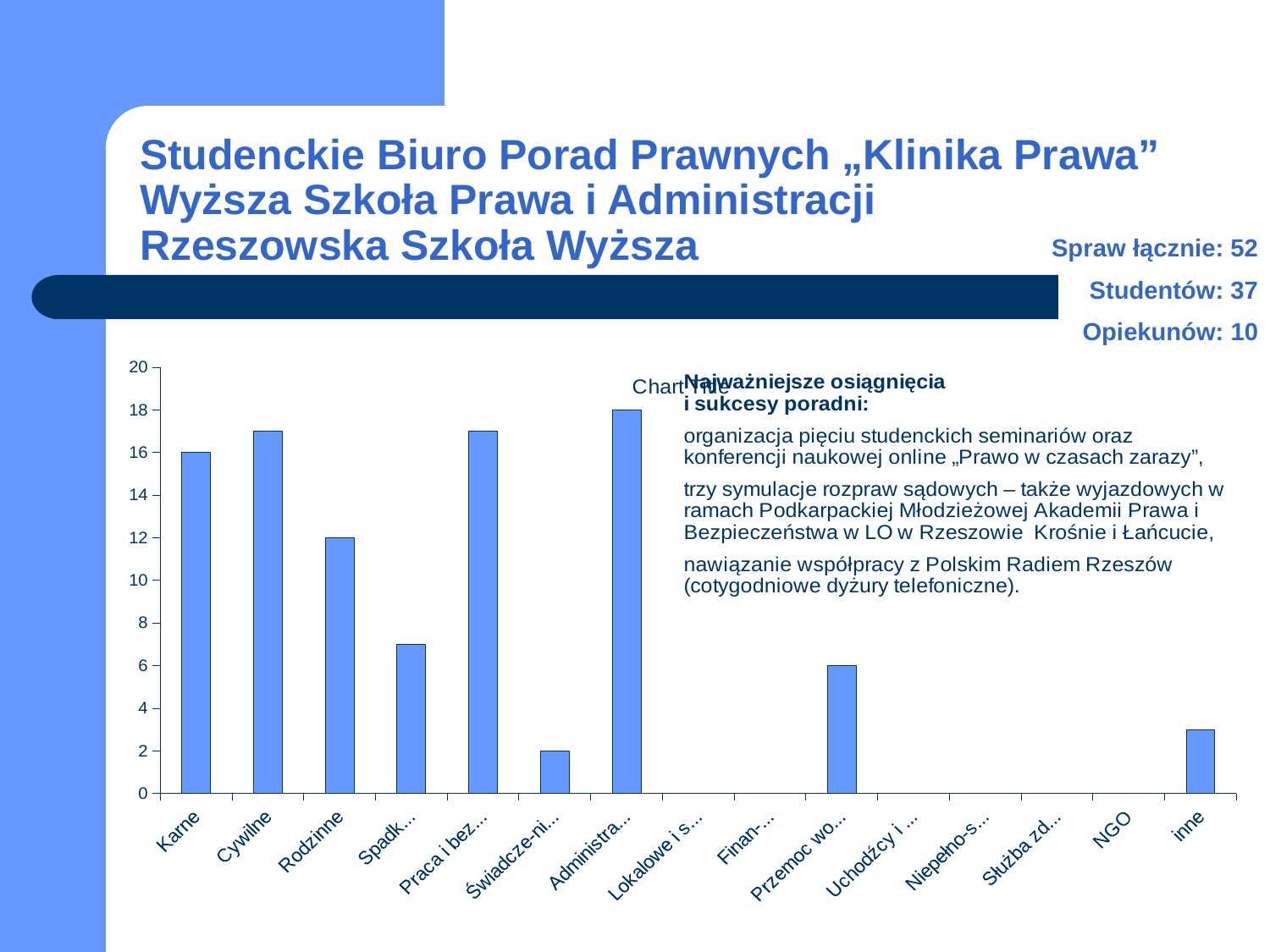
What title is printed above the chart? Chart Title Which is larger, the value for Karne or the value for Rodzinne? Karne What is the value for Administra...? 18 What type of chart is shown on the slide? bar chart What is the value for Przemoc wo...? 6 What is the difference between the values for Karne and Rodzinne? 4 What is the value for Rodzinne? 12 How many categories are shown on the x axis of the chart? 15 Which category has the highest value in the chart? Administra... Is the value for Spadk... greater or less than 8? less What is the value for Karne? 16 Is the value for Cywilne greater or less than 16? greater